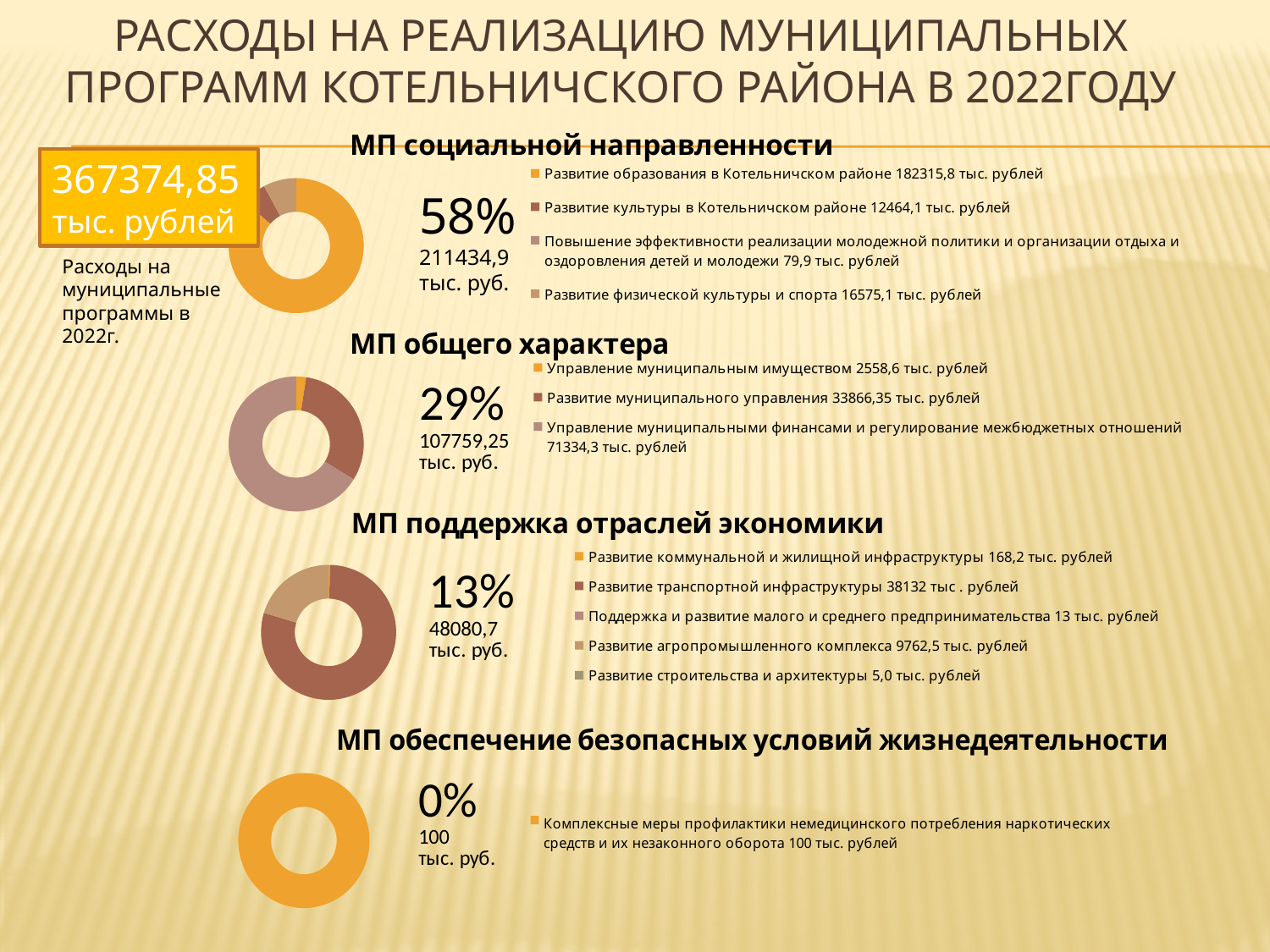
In the "МП общего характера" chart, which category has the highest value? Управление муниципальными финансами и регулирование межбюджетных отношений In the "МП социальной направленности" chart, which category has the lowest value? Повышение эффективности реализации молодежной политики и организации отдыха и оздоровления детей и молодежи In the "МП поддержка отраслей экономики" chart, which is larger: "Развитие транспортной инфраструктуры" or "Развитие агропромышленного комплекса"? Развитие транспортной инфраструктуры What is the total amount shown for the "МП общего характера" chart? 107759,25 тыс. руб. In the "МП социальной направленности" chart, what is the value for "Развитие образования в Котельничском районе"? 182315,8 тыс. рублей In the "МП общего характера" chart, what is the value for "Развитие муниципального управления"? 33866,35 тыс. рублей How many categories does the legend of the "МП социальной направленности" chart list? 4 How many categories does the legend of the "МП поддержка отраслей экономики" chart list? 5 What is the value for "Комплексные меры профилактики немедицинского потребления наркотических средств и их незаконного оборота" in the "МП обеспечение безопасных условий жизнедеятельности" chart? 100 тыс. рублей What share of total expenditure do the "МП социальной направленности" programmes account for, according to the slide? 58% What kind of chart is used for "МП социальной направленности"? Doughnut (pie) chart In the "МП поддержка отраслей экономики" chart, what is the difference between "Развитие транспортной инфраструктуры" (38132) and "Развитие агропромышленного комплекса" (9762,5)? 28369,5 тыс. рублей